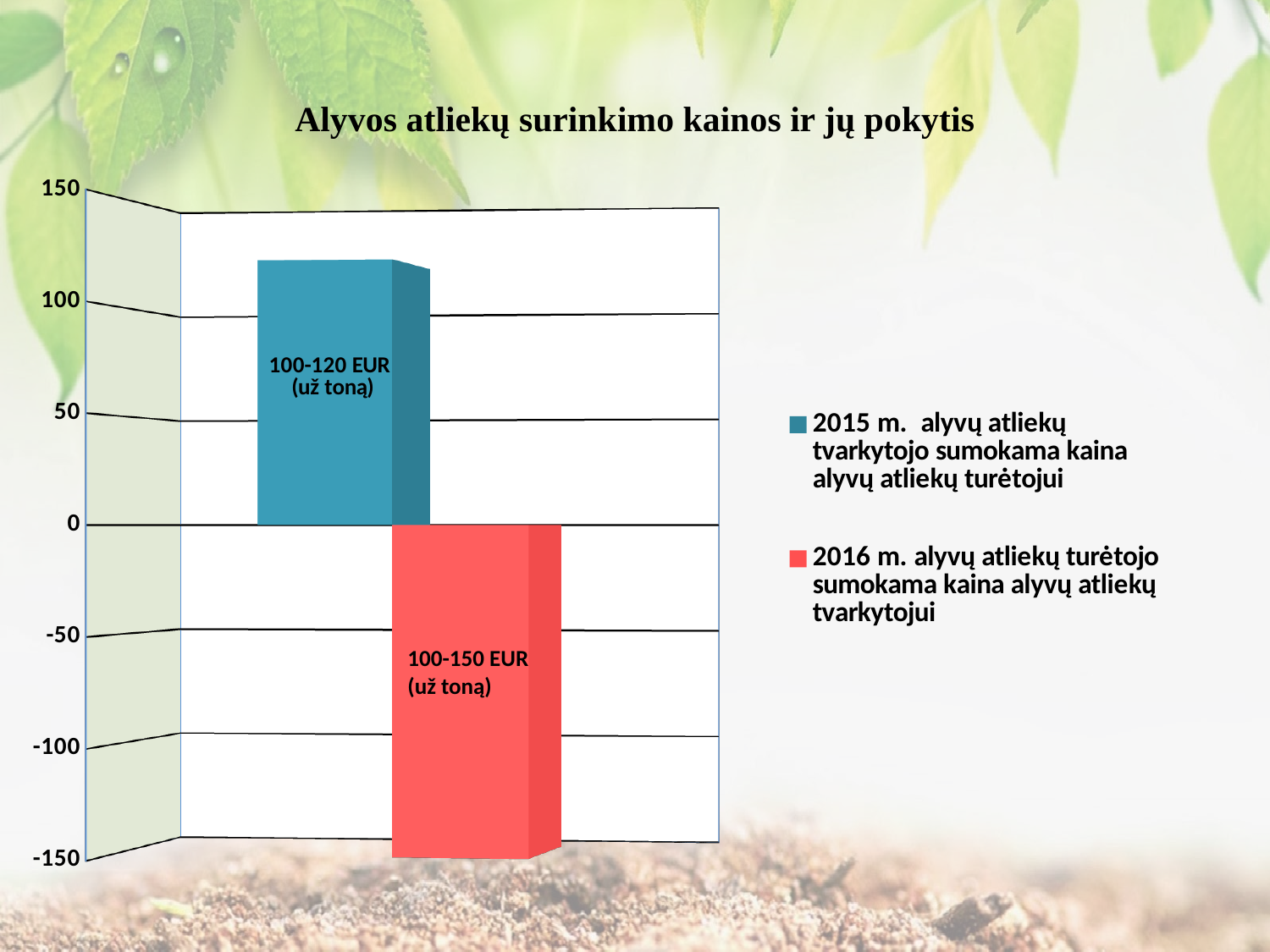
Which series is plotted below zero on the axis? 2016 m. alyvų atliekų turėtojo sumokama kaina alyvų atliekų tvarkytojui What data label is printed on the blue bar for the 2015 series? 100-120 EUR (už toną) Is the top of the blue 2015 bar greater or less than 100 on the axis? greater What colour is the bar for the 2015 series? blue What data label is printed on the red bar for the 2016 series? 100-150 EUR (už toną) Is the bottom of the red 2016 bar greater or less than -100 on the axis? less How many bars are plotted in the chart? 2 What is the lowest value shown on the vertical axis? -150 How many series does the legend list? 2 What is the title of the chart? Alyvos atliekų surinkimo kainos ir jų pokytis Is the top of the blue 2015 bar greater or less than 150 on the axis? less What kind of chart is shown on the slide? bar chart